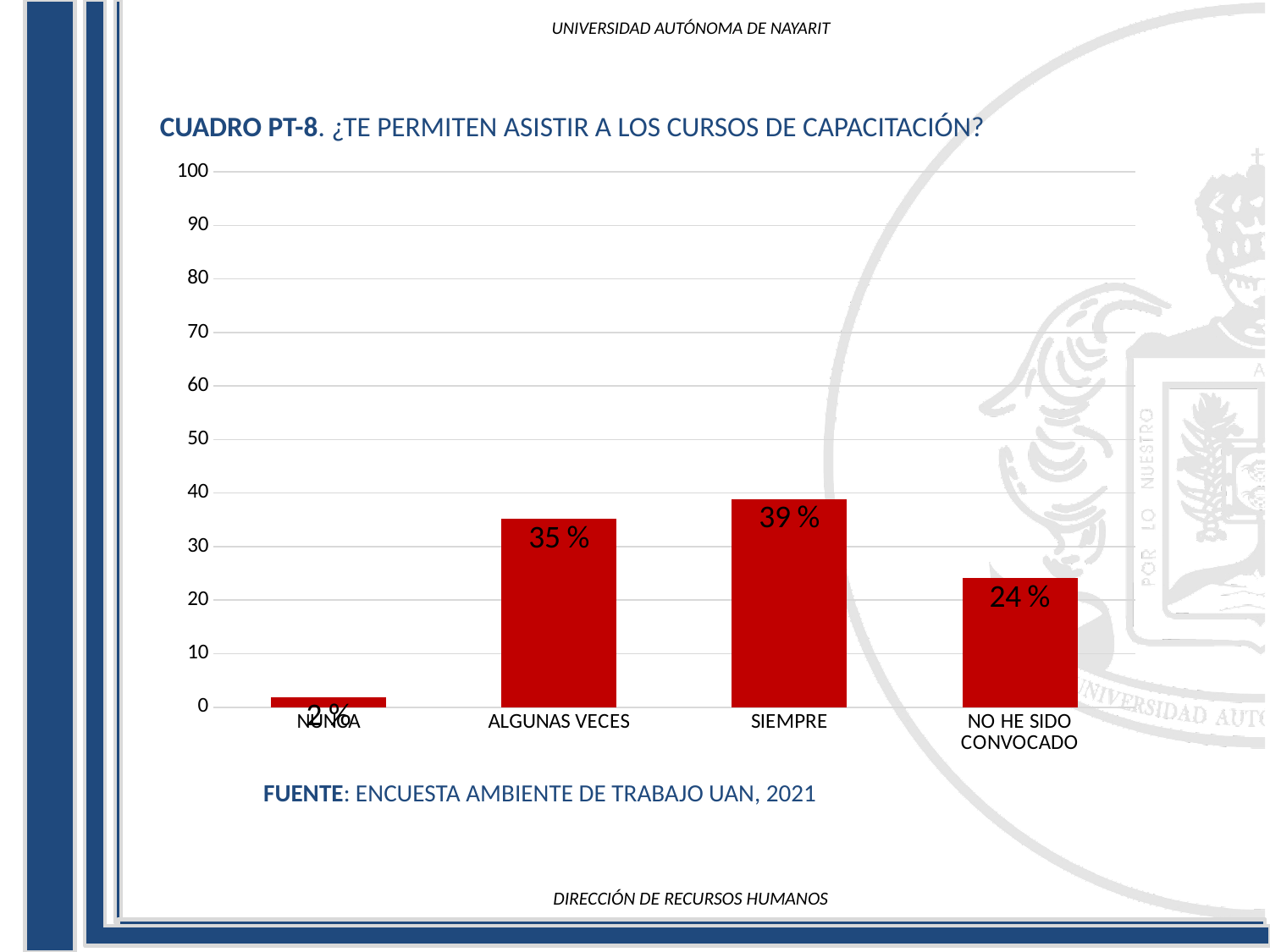
How many categories are shown on the x axis? 4 Is the value for NO HE SIDO CONVOCADO greater or less than 30? less What is the value for ALGUNAS VECES? 35 % Which category has the lowest value? NUNCA What is the value for NO HE SIDO CONVOCADO? 24 % Which category has the highest value? SIEMPRE What is the value for SIEMPRE? 39 % Which is larger, the value for NO HE SIDO CONVOCADO or the value for ALGUNAS VECES? ALGUNAS VECES What is the difference between the values for ALGUNAS VECES and NO HE SIDO CONVOCADO? 11 % What is the difference between the values for SIEMPRE and ALGUNAS VECES? 4 % What is the source cited below the chart? ENCUESTA AMBIENTE DE TRABAJO UAN, 2021 What kind of chart is shown on the slide? bar chart